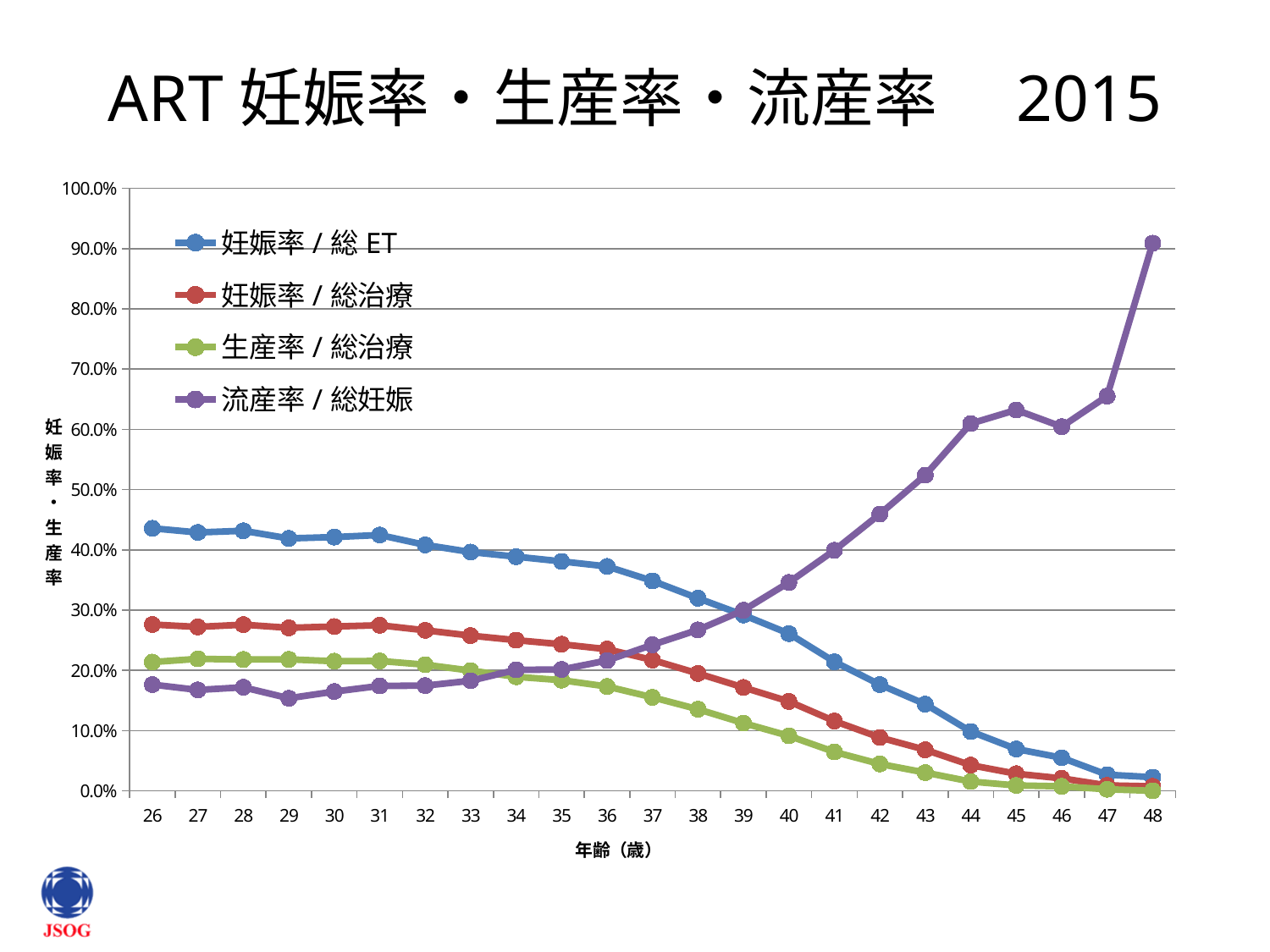
At which age is 流産率 / 総妊娠 highest? 48 How many series does the legend list? 4 Is the value of 妊娠率 / 総 ET at age 26 greater or less than 40.0%? greater Does the 妊娠率 / 総 ET series rise or fall as age increases? fall Is the value of 流産率 / 総妊娠 at age 48 greater or less than 80.0%? greater What is the title of the x axis? 年齢（歳） Is the value of 生産率 / 総治療 at age 41 greater or less than 10.0%? less At age 26, which is higher: 妊娠率 / 総 ET or 流産率 / 総妊娠? 妊娠率 / 総 ET How many age categories are plotted along the x axis? 23 Does the 流産率 / 総妊娠 series rise or fall as age increases? rise What kind of chart is shown on the slide? line chart